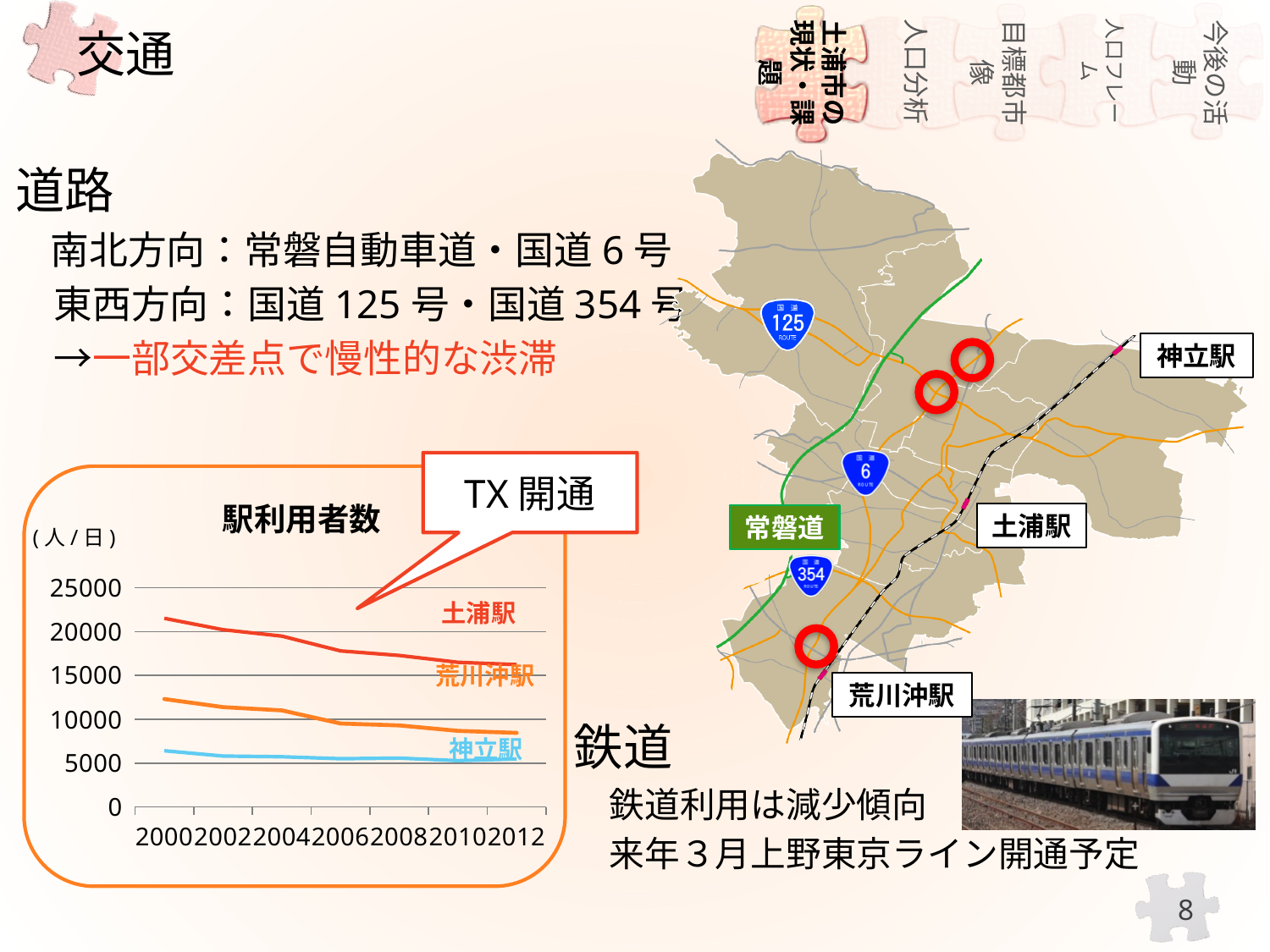
In the 駅利用者数 chart, do the values for 土浦駅 rise or fall from 2000 to 2012? fall How many series (stations) are plotted in the 駅利用者数 chart? 3 In the 駅利用者数 chart, is the value for 土浦駅 in 2000 greater or less than 20000? greater How many year labels are shown on the x axis of the 駅利用者数 chart? 7 In the 駅利用者数 chart, which station has the highest number of users throughout the period? 土浦駅 In the 駅利用者数 chart, which is larger in 2012: the value for 荒川沖駅 or the value for 神立駅? 荒川沖駅 What kind of chart is the 駅利用者数 chart? line chart In the 駅利用者数 chart, is the value for 荒川沖駅 in 2000 greater or less than 10000? greater In the 駅利用者数 chart, is the value for 荒川沖駅 in 2012 greater or less than 10000? less In the 駅利用者数 chart, which station has the lowest number of users throughout the period? 神立駅 What unit is shown for the y axis of the 駅利用者数 chart? 人/日